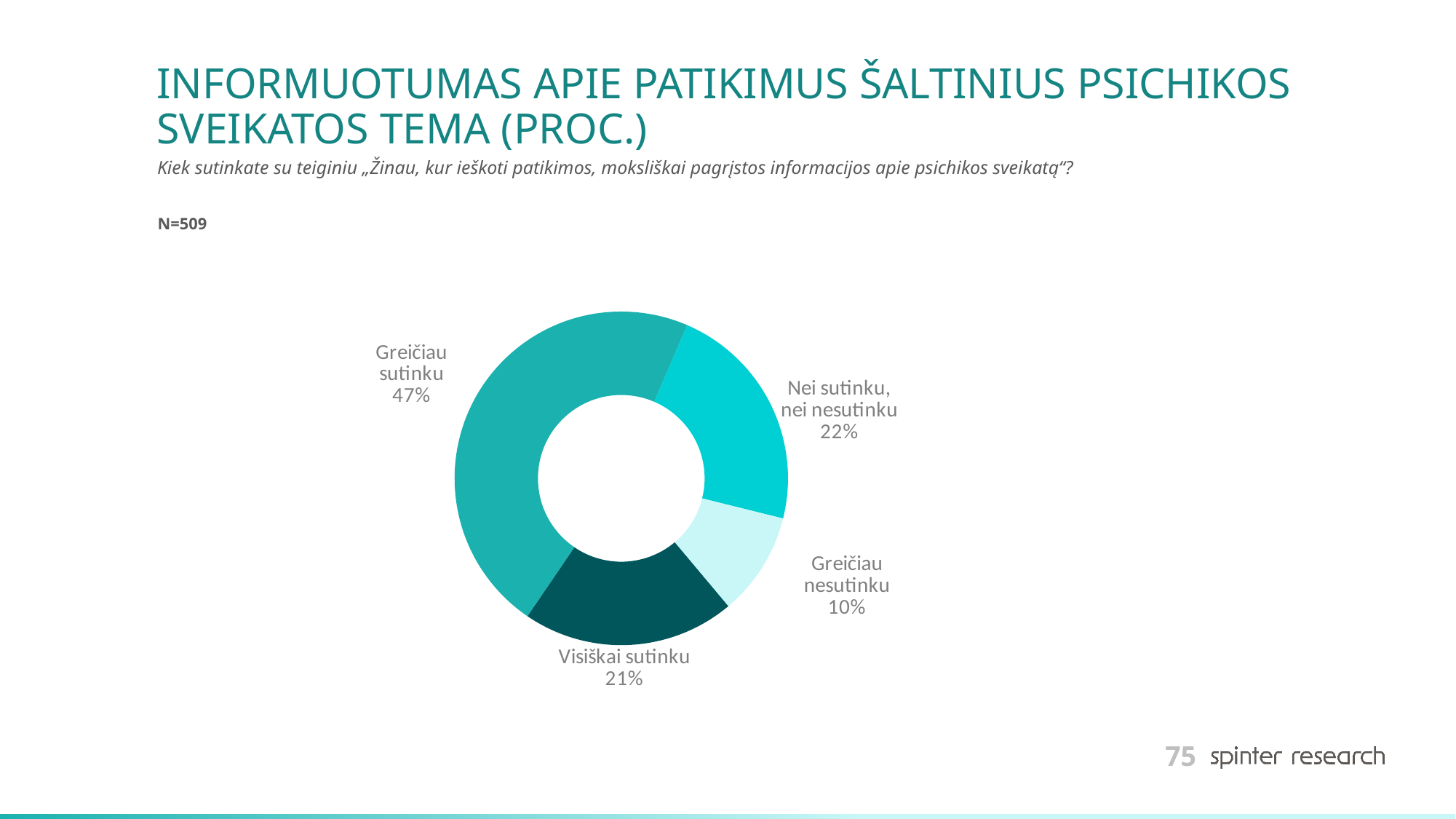
What kind of chart is shown on the slide? Donut (pie) chart What percentage of respondents answered "Greičiau sutinku"? 47% Which is larger, the share for "Greičiau sutinku" or the share for "Nei sutinku, nei nesutinku"? Greičiau sutinku What is the combined share of "Visiškai sutinku" and "Greičiau sutinku"? 68% What percentage of respondents answered "Nei sutinku, nei nesutinku"? 22% What percentage of respondents answered "Visiškai sutinku"? 21% How many response categories are shown in the chart? 4 What percentage of respondents answered "Greičiau nesutinku"? 10% What is the difference in percentage points between "Greičiau sutinku" and "Visiškai sutinku"? 26 Which response category has the smallest share? Greičiau nesutinku Which response category has the largest share? Greičiau sutinku What is the sample size (N) stated on the slide? N=509